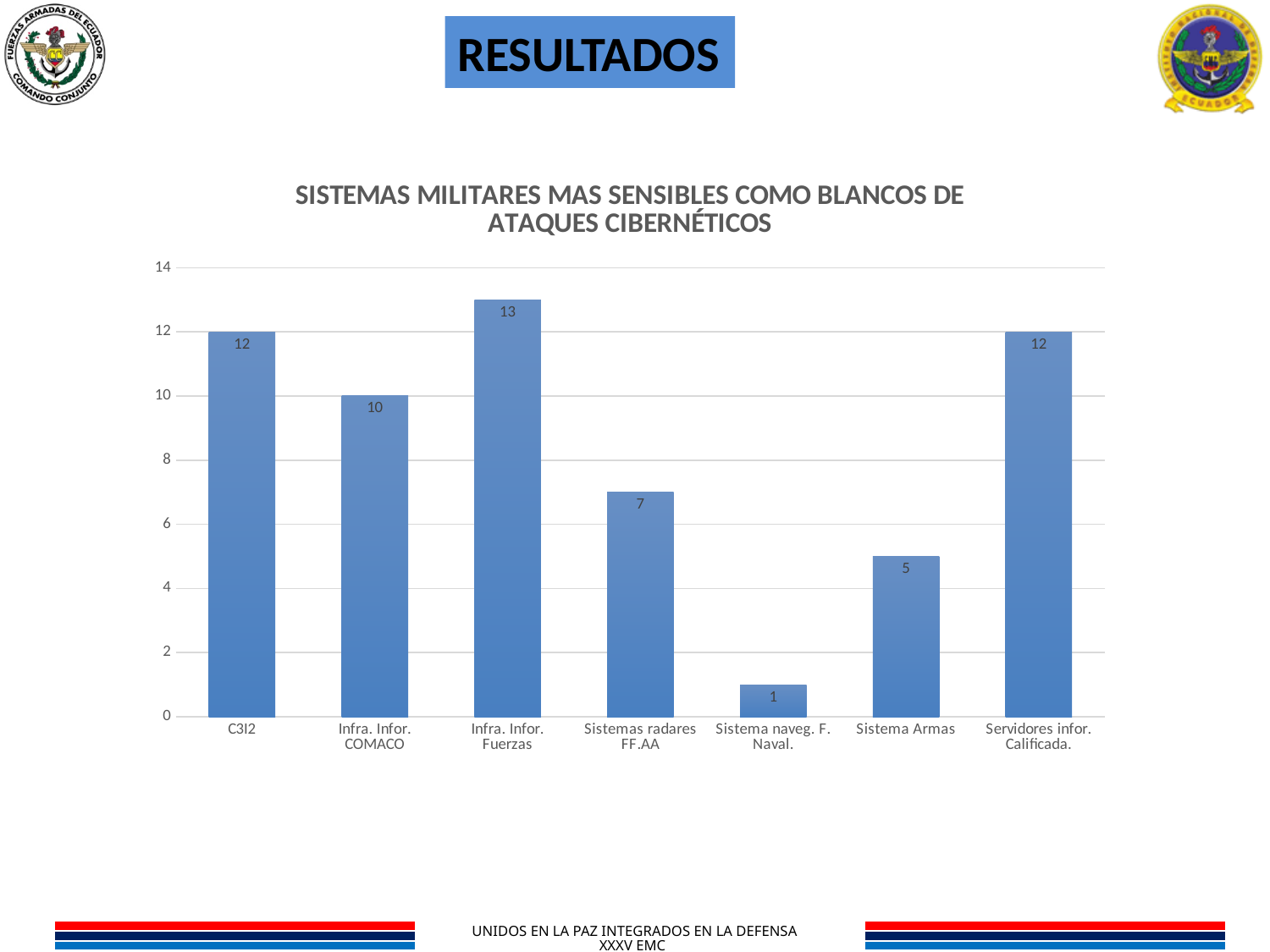
Which category has the highest value? Infra. Infor. Fuerzas Is the value for Infra. Infor. COMACO greater or less than 8? greater What is the title of the chart? SISTEMAS MILITARES MAS SENSIBLES COMO BLANCOS DE ATAQUES CIBERNÉTICOS What is the difference between the values for Infra. Infor. Fuerzas and Infra. Infor. COMACO? 3 What is the difference between the values for C3I2 and Sistema naveg. F. Naval.? 11 What is the value for Sistema Armas? 5 What kind of chart is shown on the slide? bar chart How many categories are shown on the x axis? 7 What is the value for Infra. Infor. Fuerzas? 13 Which category has the lowest value? Sistema naveg. F. Naval. What is the value for Sistemas radares FF.AA? 7 Which is larger, the value for Sistemas radares FF.AA or the value for Sistema Armas? Sistemas radares FF.AA